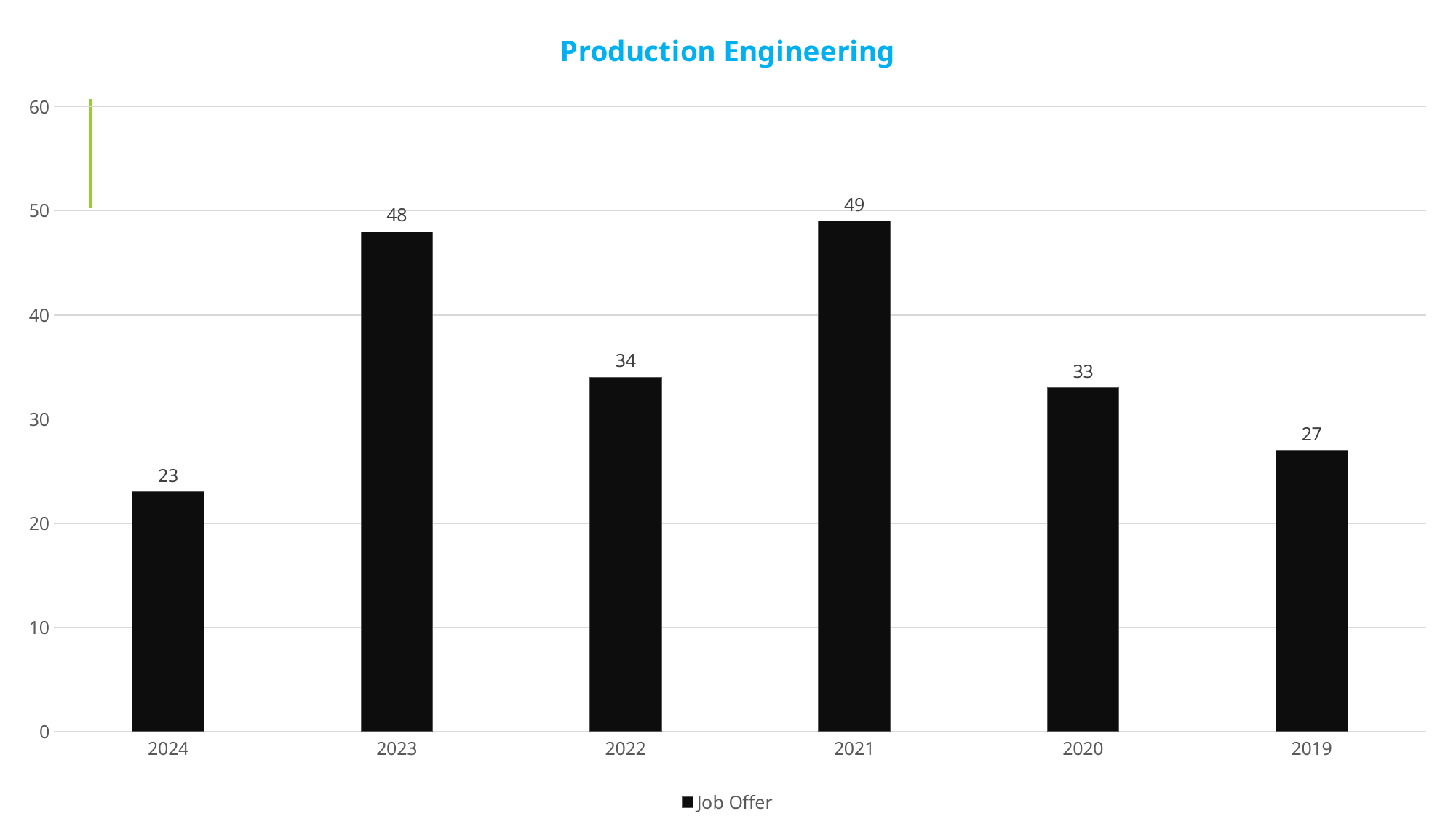
Is the Job Offer value for 2022 greater or less than 30? greater What is the Job Offer value for 2019? 27 Which year has the highest Job Offer value? 2021 How many years are shown on the x axis? 6 What is the difference between the Job Offer values for 2023 and 2022? 14 What is the Job Offer value for 2024? 23 Which year has a larger Job Offer value, 2020 or 2019? 2020 Which year has the lowest Job Offer value? 2024 How many series does the legend list? 1 What kind of chart is shown? Bar chart What is the Job Offer value for 2021? 49 What is the title of the chart? Production Engineering